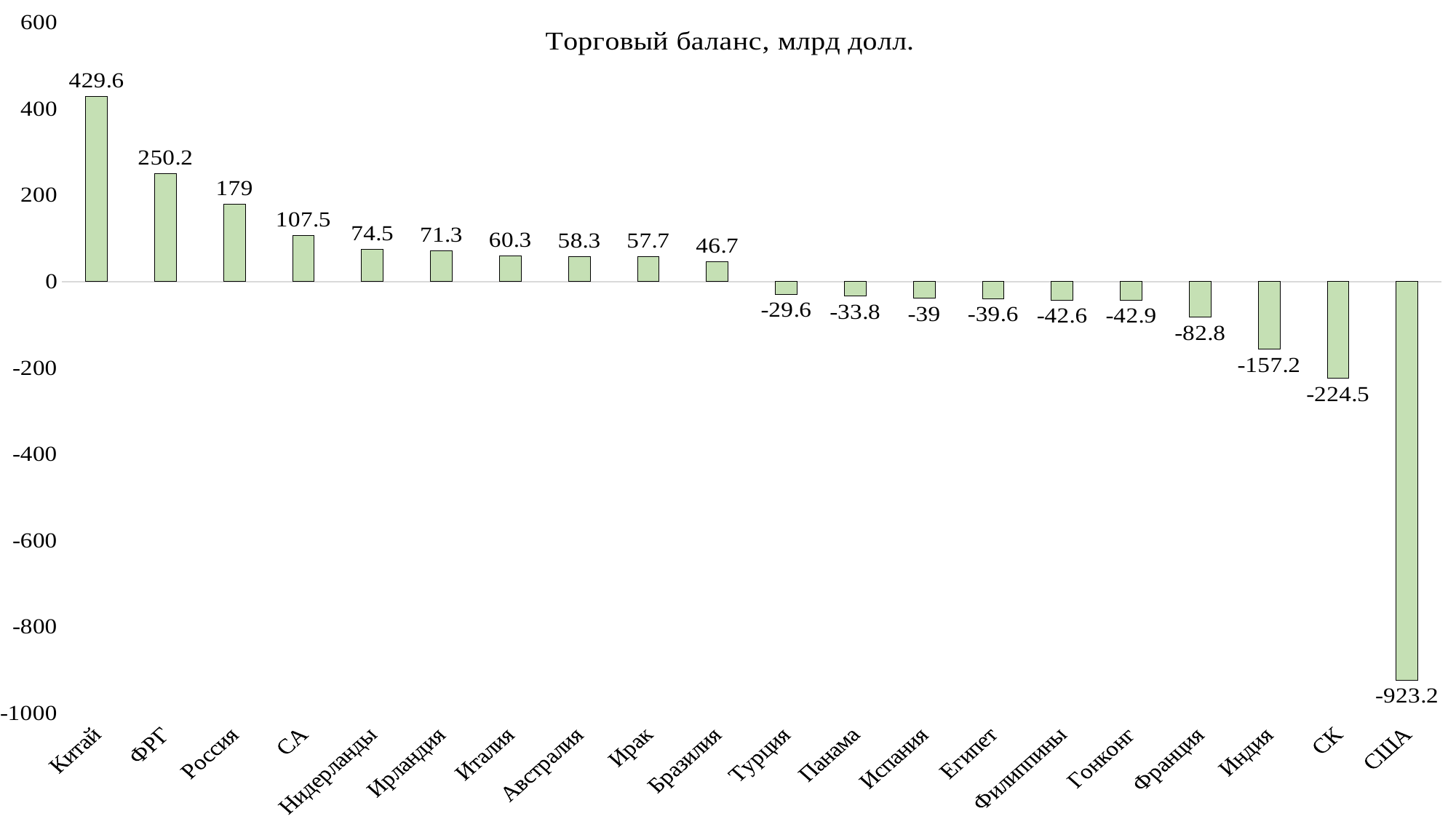
What is the value shown for Россия? 179 How many countries are shown on the chart? 20 What is the difference between the values for Китай and ФРГ? 179.4 Which country has the highest trade balance on the chart? Китай What is the title of the chart? Торговый баланс, млрд долл. What is the value shown for Индия? -157.2 What is the trade balance value shown for Китай? 429.6 What is the difference between the values for Россия and СА? 71.5 What is the value shown for Гонконг? -42.9 Which country has the lowest trade balance on the chart? США Which has a larger trade balance, Нидерланды or Бразилия? Нидерланды What kind of chart is this? Bar chart